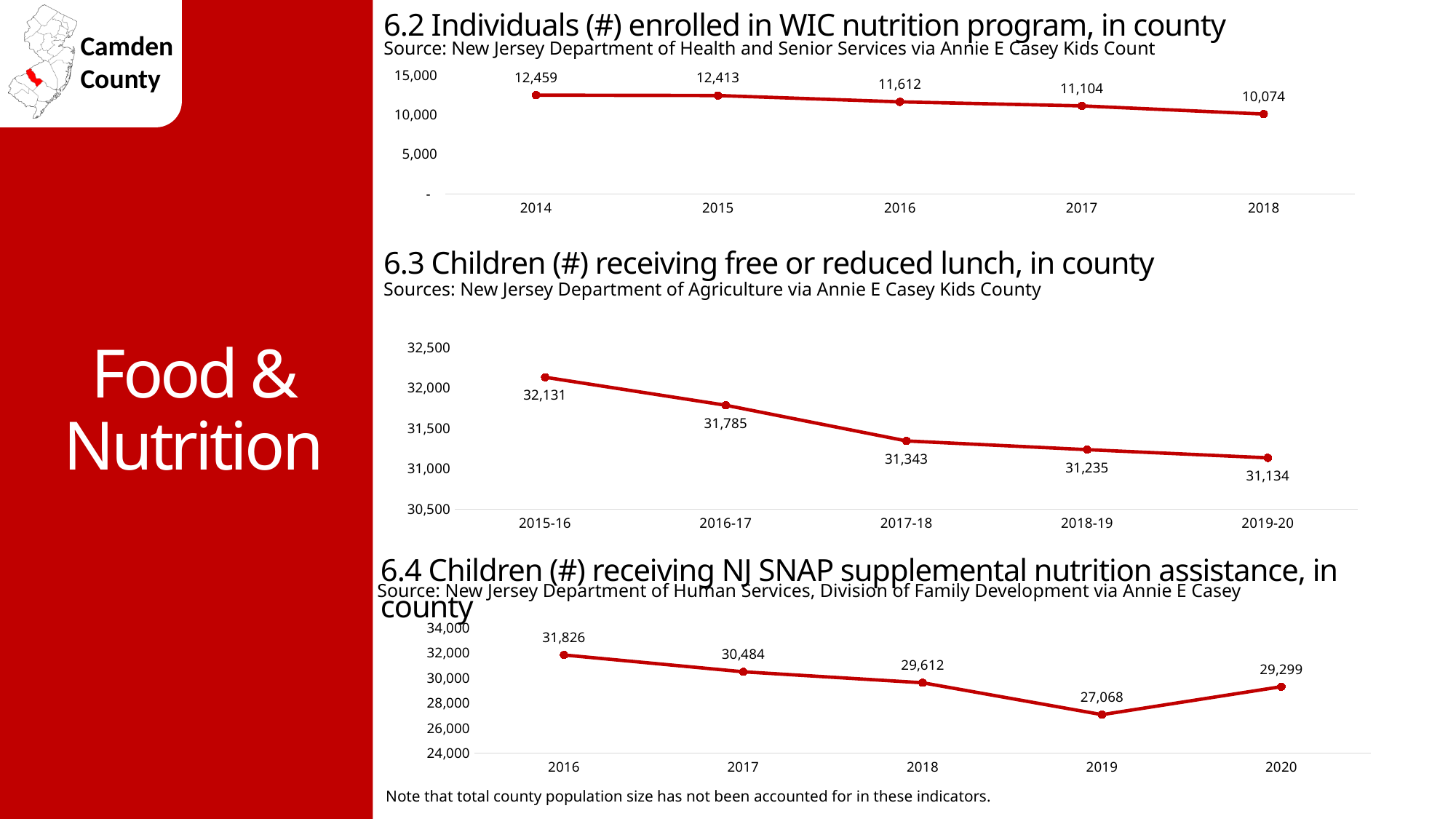
In the chart '6.3 Children (#) receiving free or reduced lunch, in county', what is the value for 2017-18? 31,343 In the chart '6.4 Children (#) receiving NJ SNAP supplemental nutrition assistance, in county', which year has the lowest value? 2019 In the chart '6.2 Individuals (#) enrolled in WIC nutrition program, in county', what is the difference between the 2014 and 2018 values? 2,385 In the chart '6.3 Children (#) receiving free or reduced lunch, in county', which school year has the highest value? 2015-16 In the chart '6.4 Children (#) receiving NJ SNAP supplemental nutrition assistance, in county', which is larger, the value for 2018 or the value for 2020? 2018 In the chart '6.2 Individuals (#) enrolled in WIC nutrition program, in county', which year has the lowest value? 2018 In the chart '6.3 Children (#) receiving free or reduced lunch, in county', do the values rise or fall from 2015-16 to 2019-20? fall In the chart '6.4 Children (#) receiving NJ SNAP supplemental nutrition assistance, in county', what is the difference between the 2016 and 2017 values? 1,342 In the chart '6.2 Individuals (#) enrolled in WIC nutrition program, in county', how many years are plotted? 5 In the chart '6.4 Children (#) receiving NJ SNAP supplemental nutrition assistance, in county', what is the value for 2019? 27,068 What kind of chart is '6.3 Children (#) receiving free or reduced lunch, in county'? line chart In the chart '6.2 Individuals (#) enrolled in WIC nutrition program, in county', what is the value for 2016? 11,612